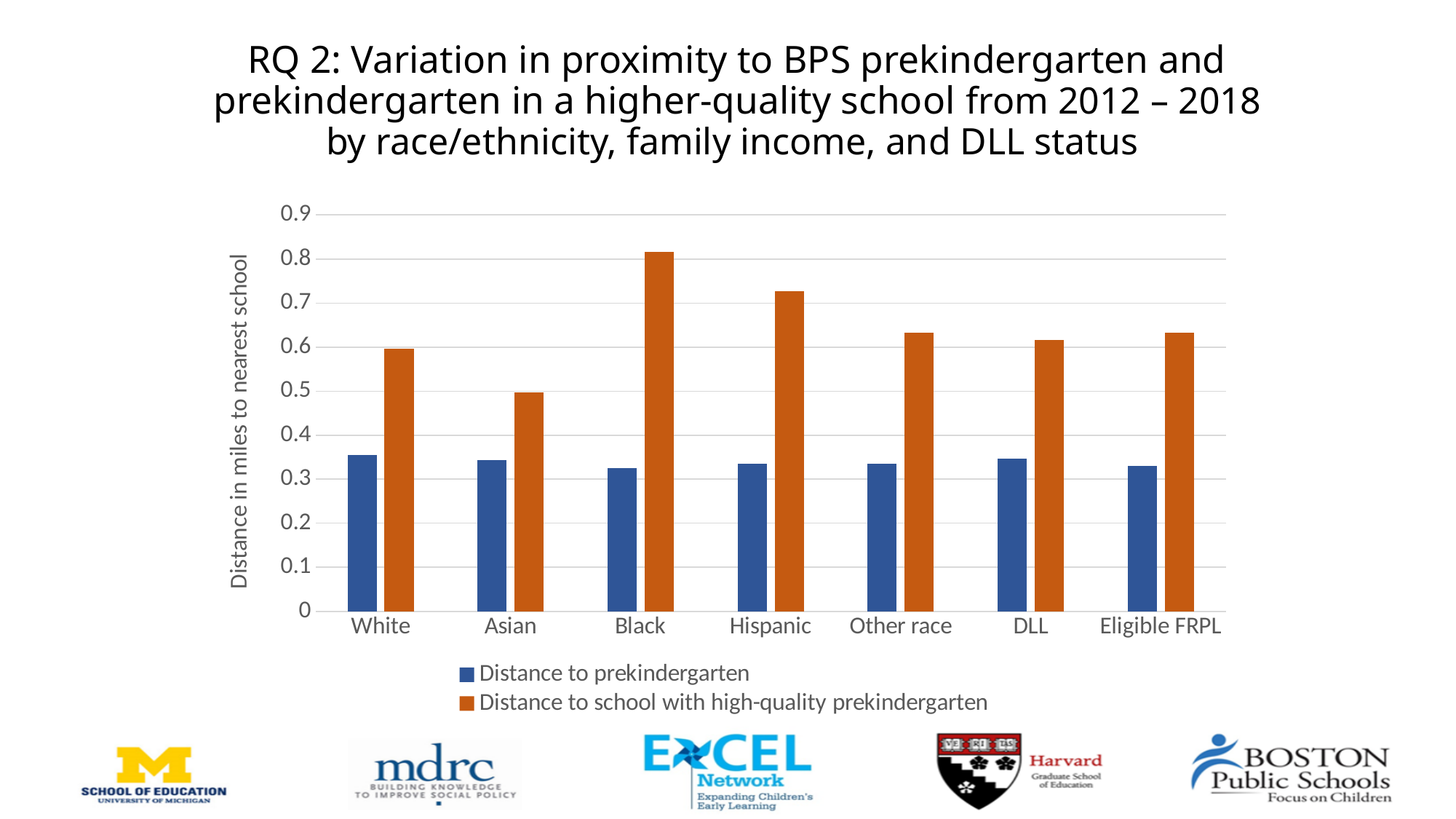
Is the value for Black in the Distance to school with high-quality prekindergarten series greater or less than 0.7? greater Is the value for White in the Distance to prekindergarten series greater or less than 0.4? less How many categories are shown along the x axis? 7 What kind of chart is shown on the slide? bar chart Which category has the highest value for Distance to school with high-quality prekindergarten? Black Which is larger for Hispanic: Distance to prekindergarten or Distance to school with high-quality prekindergarten? Distance to school with high-quality prekindergarten Which category has the larger value for Distance to school with high-quality prekindergarten: Hispanic or Other race? Hispanic How many series does the legend list? 2 Which category has the lowest value for Distance to school with high-quality prekindergarten? Asian What is the label of the y axis? Distance in miles to nearest school Is the value for Asian in the Distance to school with high-quality prekindergarten series greater or less than 0.4? greater